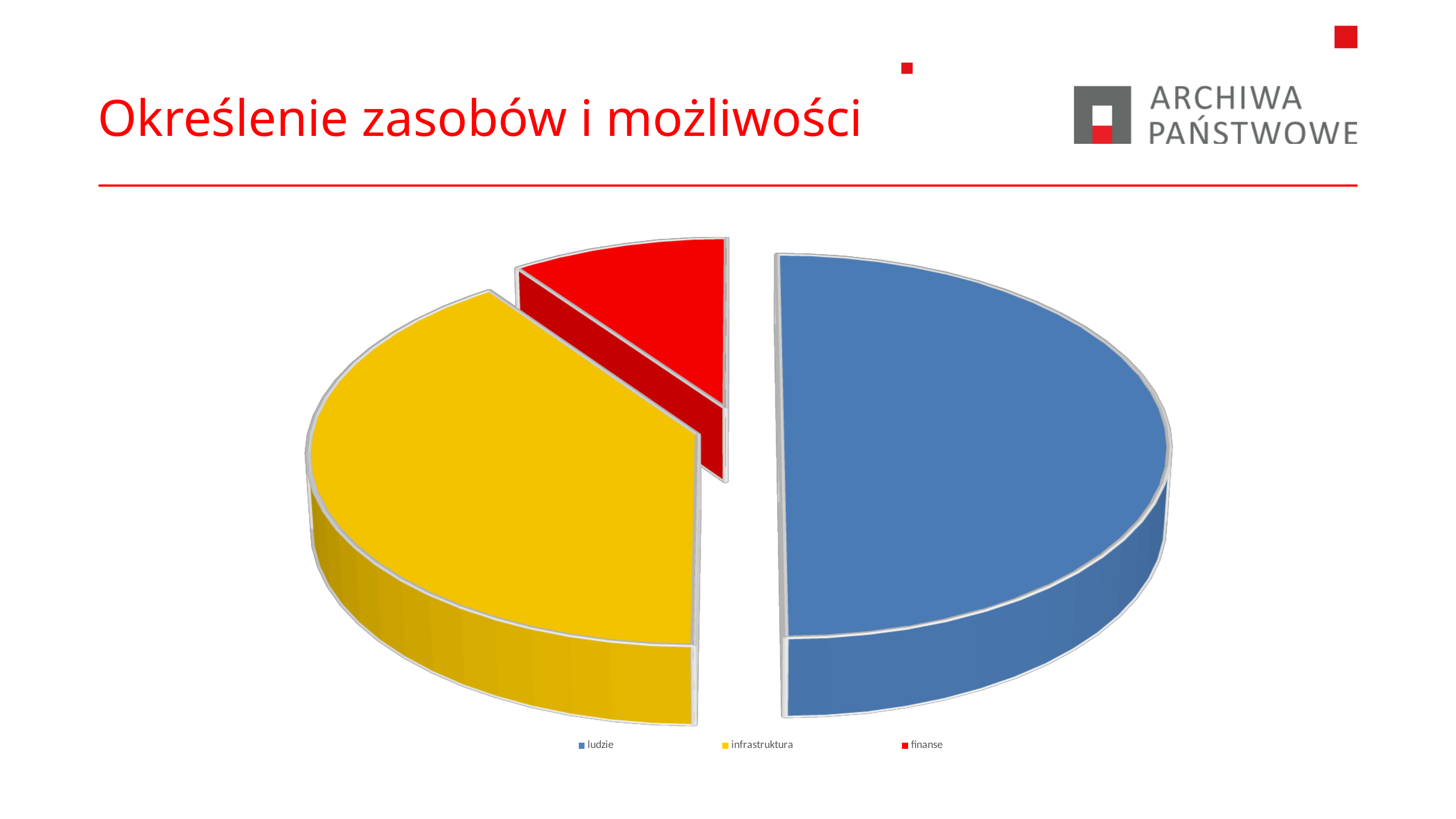
Which category has the smallest slice in the pie chart? finanse Which category is shown in red in the pie chart? finanse What kind of chart is shown on the slide? pie chart How many entries does the legend of the pie chart list? 3 How many slices does the pie chart have? 3 What colour is the slice for infrastruktura in the pie chart? yellow Which slice is larger, ludzie or finanse? ludzie Which slice is larger, infrastruktura or finanse? infrastruktura Which category has the largest slice in the pie chart? ludzie Which slice is larger, ludzie or infrastruktura? ludzie